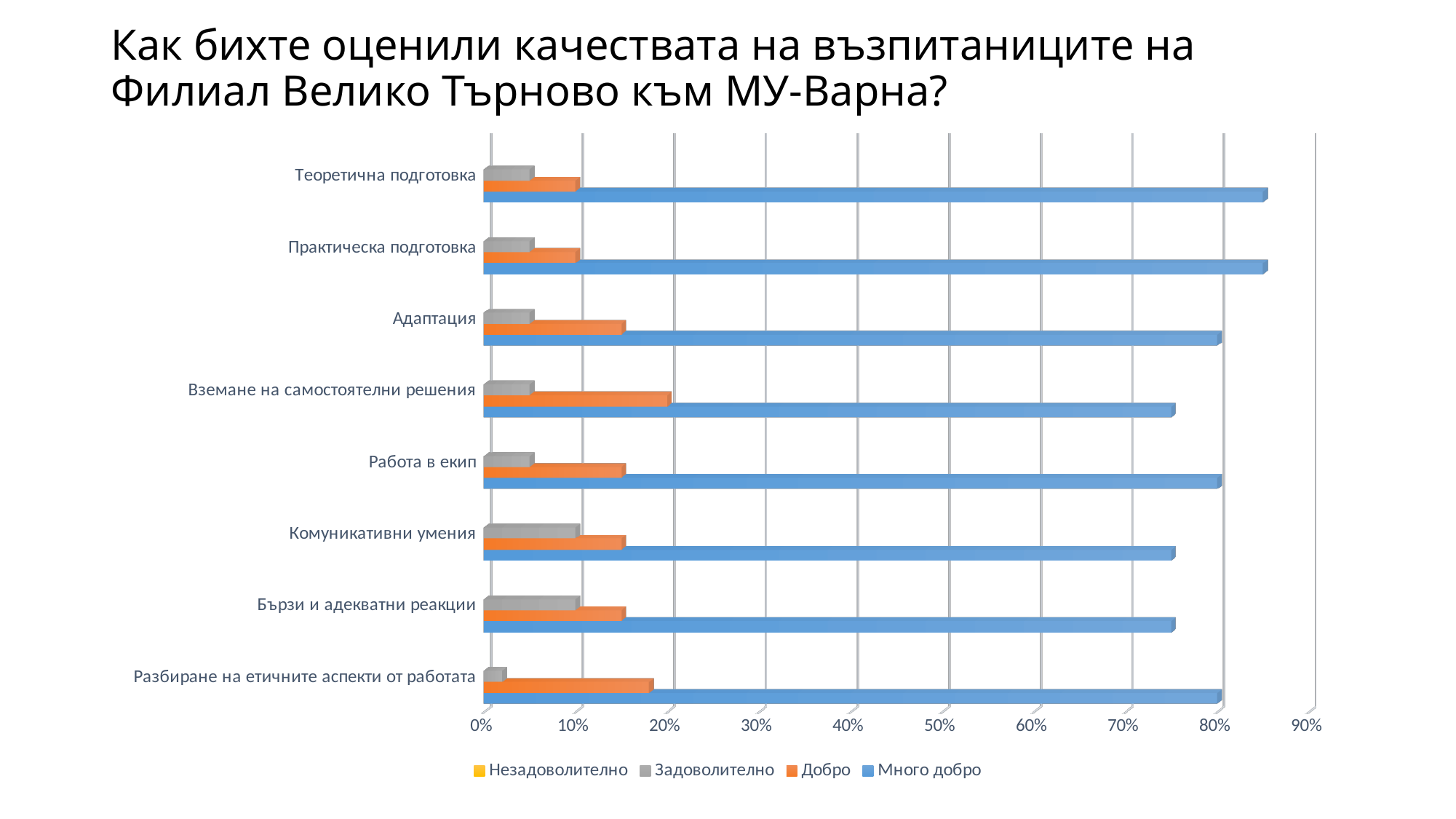
Is the 'Много добро' value for 'Теоретична подготовка' greater or less than 80%? greater What colour are the 'Много добро' bars in the chart? blue Is the 'Добро' value for 'Разбиране на етичните аспекти от работата' greater or less than 20%? less What kind of chart is shown on the slide? bar chart Is the 'Задоволително' value for 'Разбиране на етичните аспекти от работата' greater or less than 10%? less Which series is listed first in the chart legend? Незадоволително Which is larger: the 'Добро' value for 'Вземане на самостоятелни решения' or for 'Теоретична подготовка'? Вземане на самостоятелни решения How many series does the chart legend list? 4 How many categories (qualities) are listed on the vertical axis of the chart? 8 Which is larger: the 'Много добро' value for 'Адаптация' or for 'Комуникативни умения'? Адаптация Which category has the lowest 'Задоволително' value? Разбиране на етичните аспекти от работата